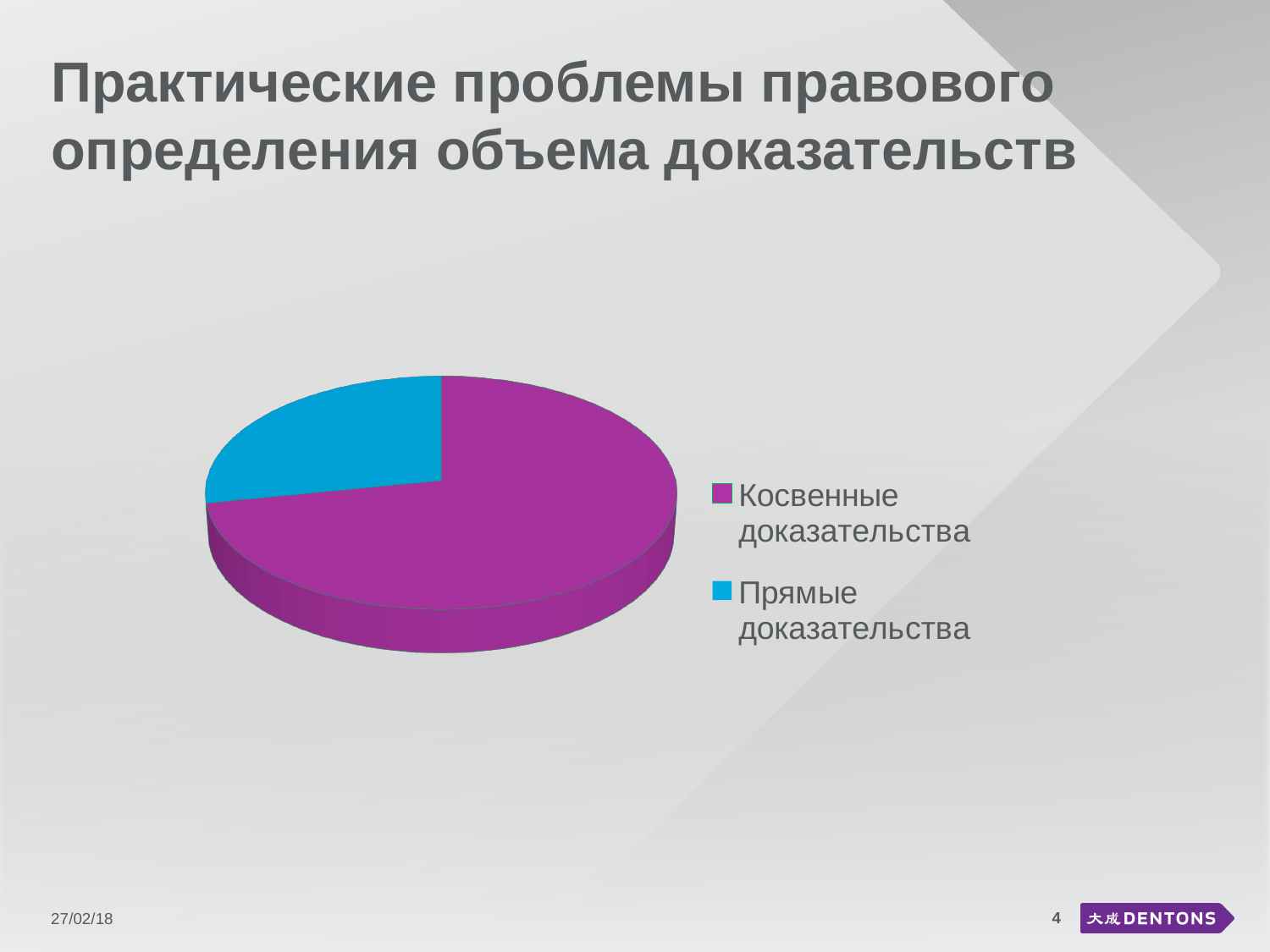
How many entries does the legend of the pie chart list? 2 What kind of chart is shown on the slide? pie chart Which category has the smallest slice in the pie chart? Прямые доказательства How many slices does the pie chart have? 2 Which category has the largest slice in the pie chart? Косвенные доказательства What colour is the slice for Косвенные доказательства? purple What colour is the slice for Прямые доказательства? blue Which slice is larger: Косвенные доказательства or Прямые доказательства? Косвенные доказательства